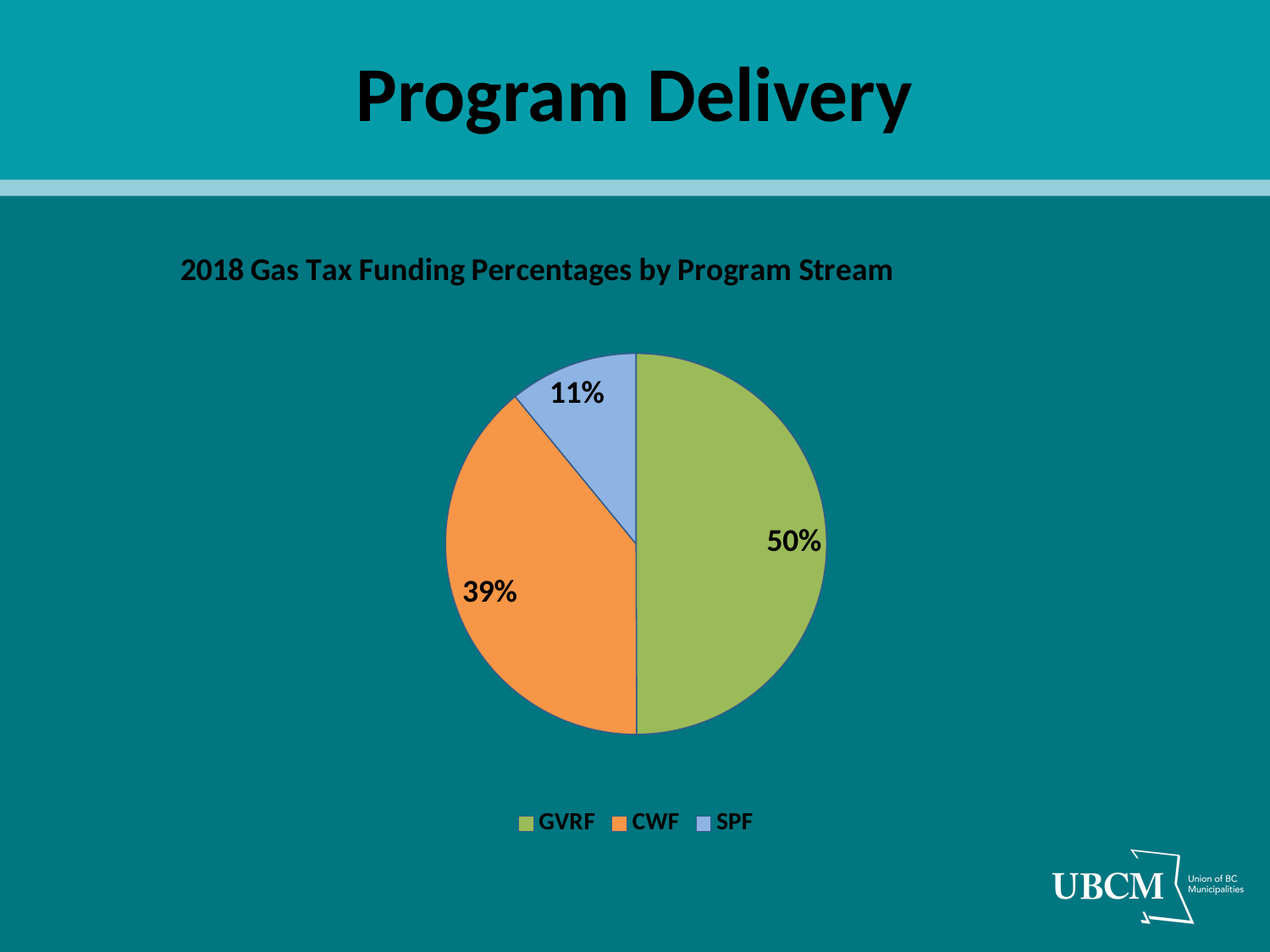
Which colour represents CWF in the pie chart? Orange What is the title of the chart? 2018 Gas Tax Funding Percentages by Program Stream What type of chart is shown on the slide? Pie chart What percentage of 2018 Gas Tax funding went to GVRF? 50% Which has a larger share, CWF or SPF? CWF What percentage of 2018 Gas Tax funding went to CWF? 39% What percentage of 2018 Gas Tax funding went to SPF? 11% Which program stream has the largest share of the pie? GVRF What is the difference in percentage points between the CWF and SPF shares? 28 Which program stream has the smallest share of the pie? SPF What is the difference in percentage points between the GVRF and CWF shares? 11 How many program streams are shown in the pie chart? 3